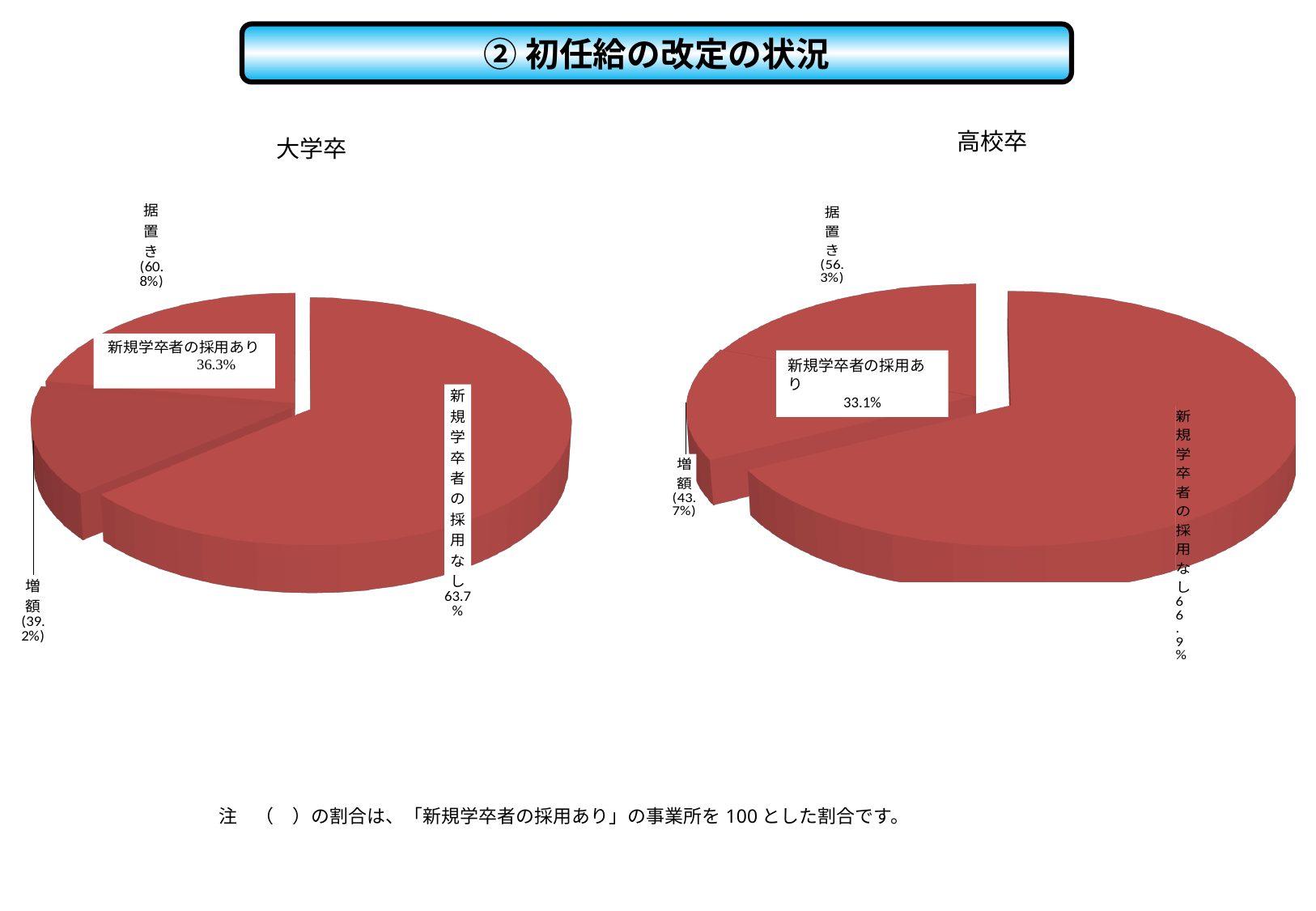
In the 高校卒 chart, what percentage is shown for 新規学卒者の採用なし? 66.9% What is the difference between 新規学卒者の採用なし and 新規学卒者の採用あり in the 大学卒 chart? 27.4% In the 大学卒 chart, what percentage is shown for 新規学卒者の採用あり? 36.3% In the 高校卒 chart, what percentage is shown in parentheses for 増額? 43.7% In the 高校卒 chart, what percentage is shown in parentheses for 据置き? 56.3% In the 大学卒 chart, what percentage is shown in parentheses for 増額? 39.2% Which is larger: 新規学卒者の採用なし in the 大学卒 chart or in the 高校卒 chart? 高校卒 What is the difference between 据置き and 増額 in the 高校卒 chart? 12.6% What kind of chart is used for 大学卒? Pie chart In the 高校卒 chart, what percentage is shown for 新規学卒者の採用あり? 33.1% In the 大学卒 chart, what percentage is shown in parentheses for 据置き? 60.8% In the 大学卒 chart, what percentage is shown for 新規学卒者の採用なし? 63.7%